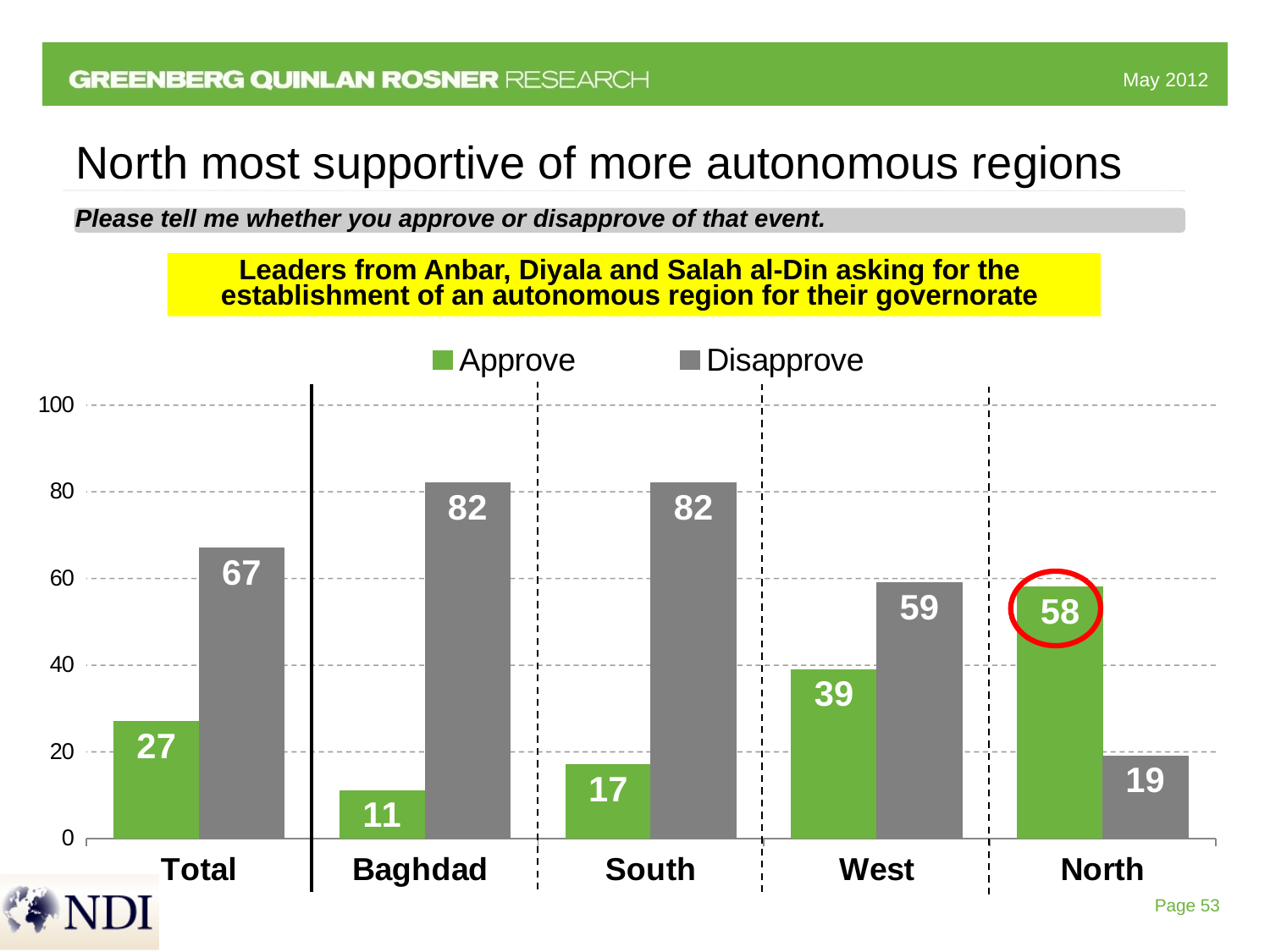
What kind of chart is shown on the slide? Bar chart What is the Disapprove value for Baghdad? 82 How many series does the legend list? 2 What is the Approve value for Total? 27 Which region has the highest Approve value? North What is the difference between the Disapprove and Approve values for West? 20 Which region has the lowest Disapprove value? North How many categories are shown on the x axis? 5 Which is larger, the Approve value for South or the Approve value for West? West Which series is shown in green? Approve Which region has the lowest Approve value? Baghdad What is the Approve value for North? 58